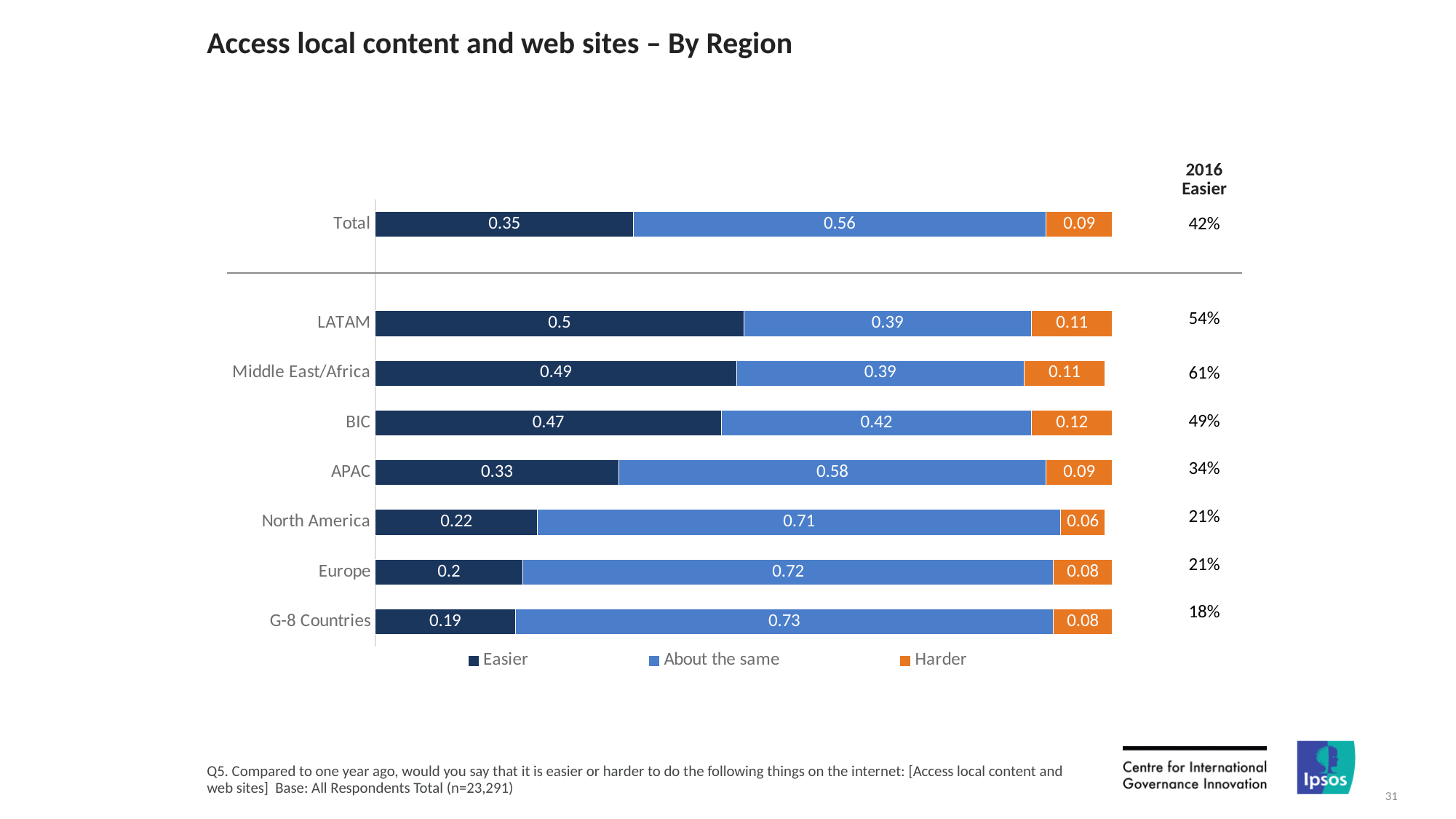
What is the total of the stacked bar for Total? 1 How many series does the legend list? 3 How many regions (including Total) are plotted on the chart? 8 What is the 'Easier' value for LATAM? 0.5 What is the '2016 Easier' percentage shown for Middle East/Africa? 61% What is the 'Harder' value for BIC? 0.12 Which is larger, the 'Easier' value for BIC or for APAC? BIC Which region has the highest 'Easier' value? LATAM Which region has the lowest 'Easier' value? G-8 Countries What is the 'About the same' value for North America? 0.71 What type of chart is shown on the slide? Stacked bar chart What is the difference between the 'Easier' values for LATAM and G-8 Countries? 0.31